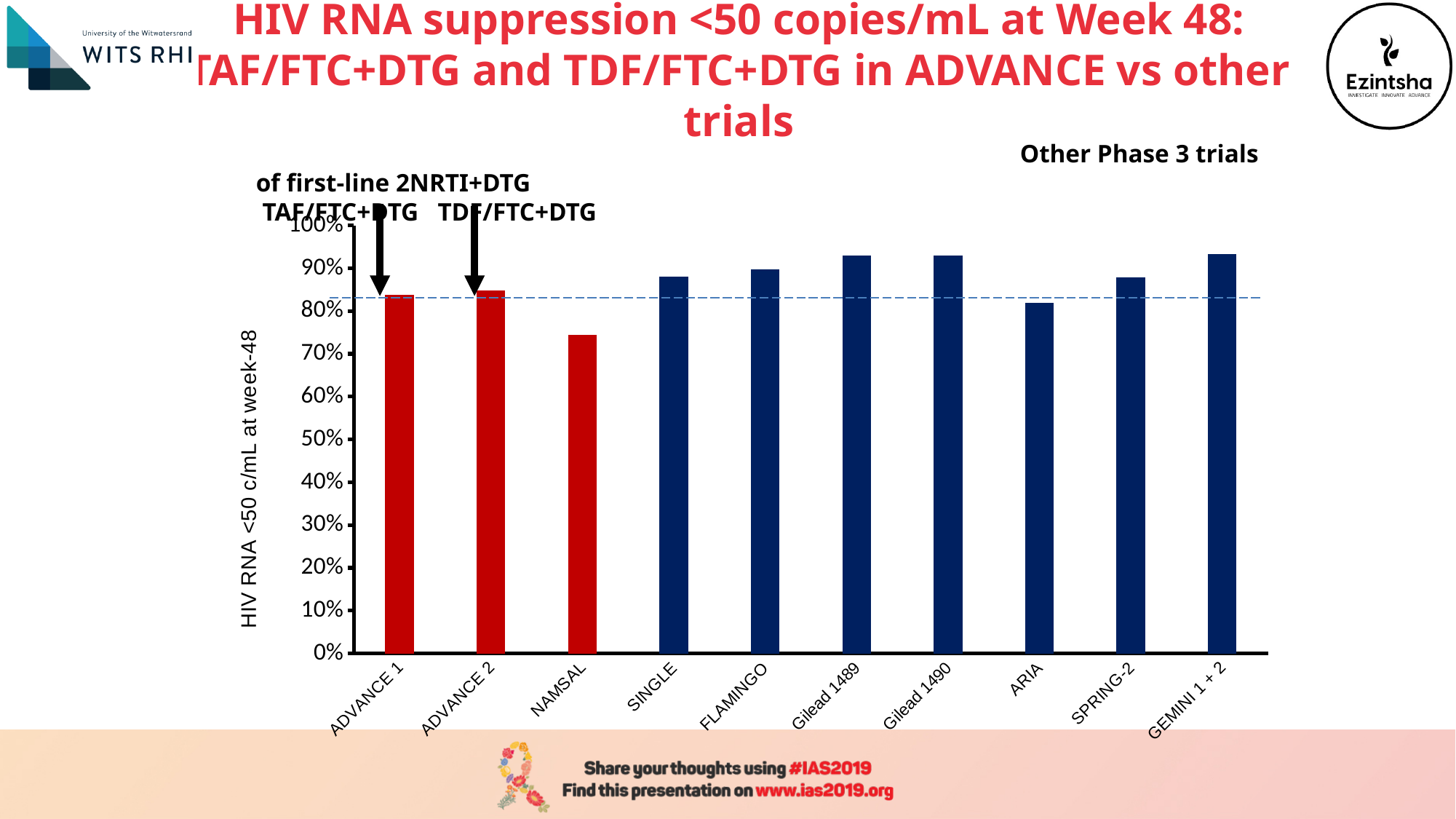
Which has the larger value, ARIA or GEMINI 1 + 2? GEMINI 1 + 2 How many bars in the chart are coloured red? 3 What kind of chart is shown on the slide? bar chart Is the value for Gilead 1489 greater or less than 90%? greater Which has the larger value, NAMSAL or SINGLE? SINGLE Is the value for GEMINI 1 + 2 greater or less than 90%? greater How many trials (bars) are shown on the x axis of the chart? 10 Is the value for SPRING-2 greater or less than 90%? less Which trial has the lowest HIV RNA suppression value in the chart? NAMSAL What is the label on the y axis of the chart? HIV RNA <50 c/mL at week-48